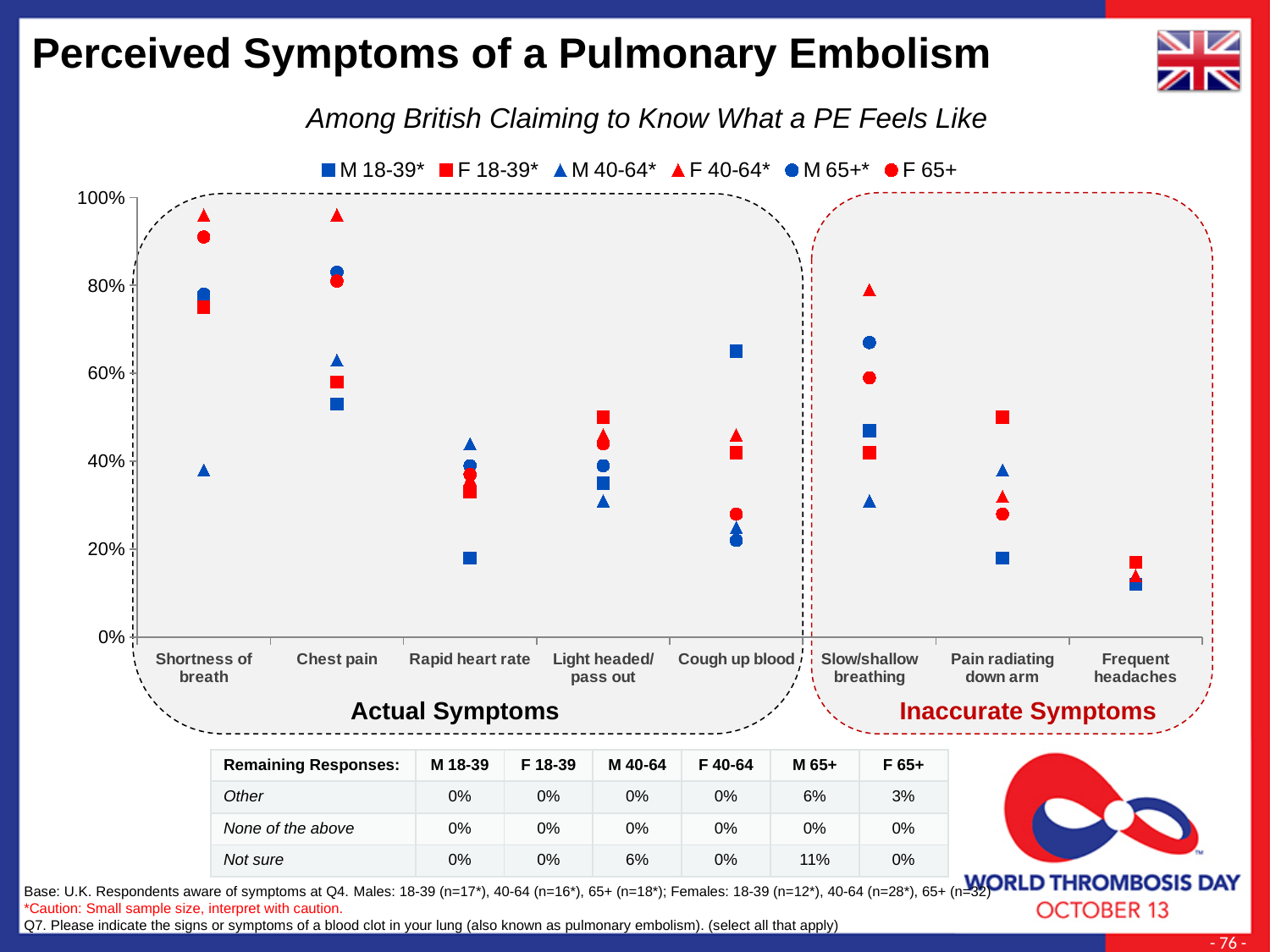
Is the value for F 40-64 for Chest pain greater or less than 80%? greater For Chest pain, which is larger: the value for F 40-64 or the value for M 40-64? F 40-64 Which symptom has the highest value for the M 18-39 series? Shortness of breath Is the value for M 18-39 for Cough up blood greater or less than 60%? greater How many series does the legend list? 6 What kind of chart is shown on the slide? scatter chart Is the value for F 40-64 for Slow/shallow breathing greater or less than 60%? greater How many symptom categories are plotted along the x axis? 8 Which symptom has the lowest values overall across the series? Frequent headaches Which symptoms are grouped under the label 'Inaccurate Symptoms'? Slow/shallow breathing, Pain radiating down arm, Frequent headaches